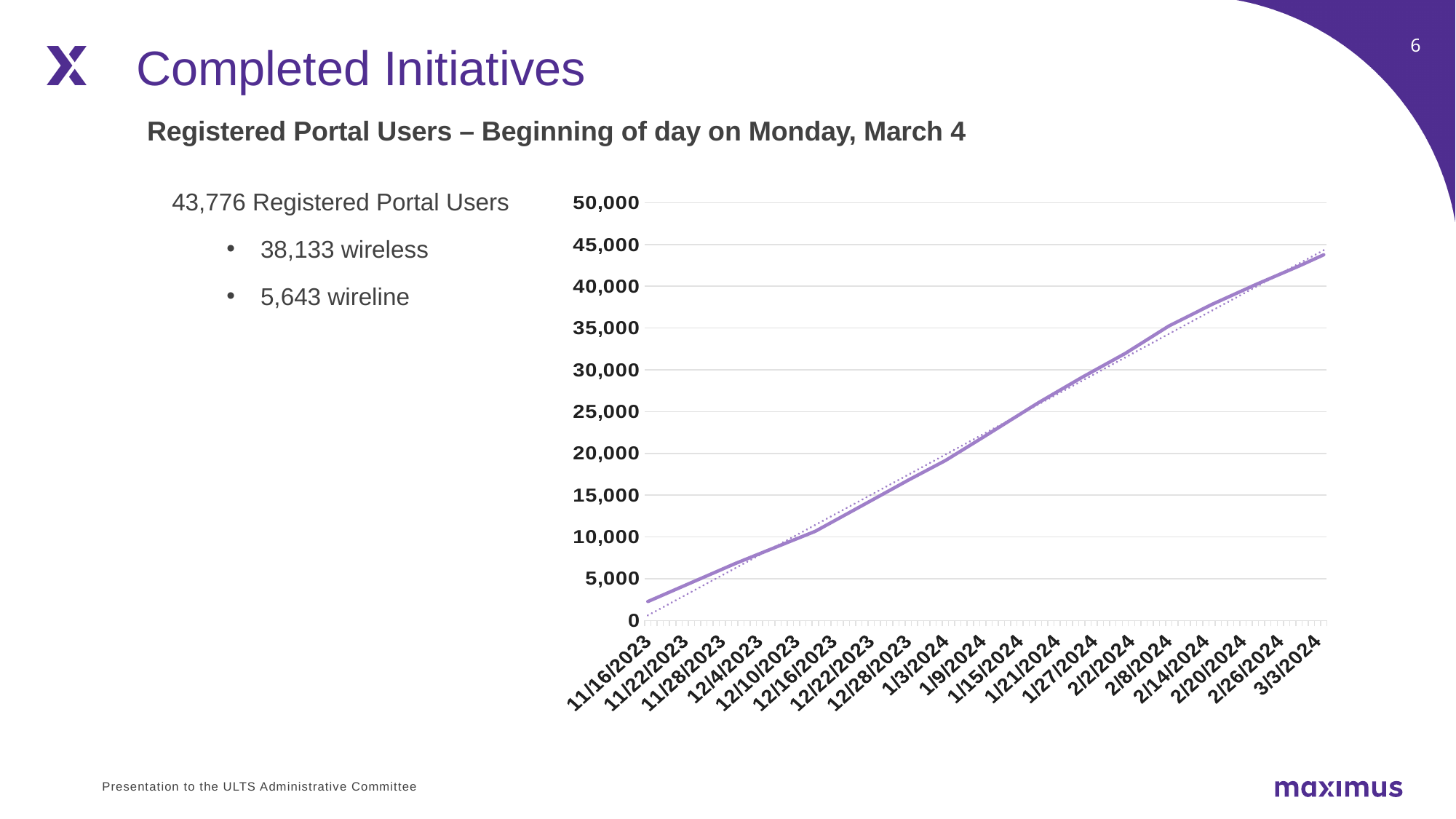
Is the value for 2/14/2024 greater or less than 35,000? greater Which date on the x axis has the lowest value on the chart? 11/16/2023 Which has the larger value, 12/22/2023 or 2/2/2024? 2/2/2024 Is the value for 11/16/2023 greater or less than 5,000? less What kind of chart is shown on the slide? line chart Is the value for 1/3/2024 greater or less than 20,000? less What is the highest value shown on the chart's y axis? 50,000 How many date labels are shown along the x axis of the chart? 19 Do the values on the chart rise or fall from 11/16/2023 to 3/3/2024? rise Which date on the x axis has the highest value on the chart? 3/3/2024